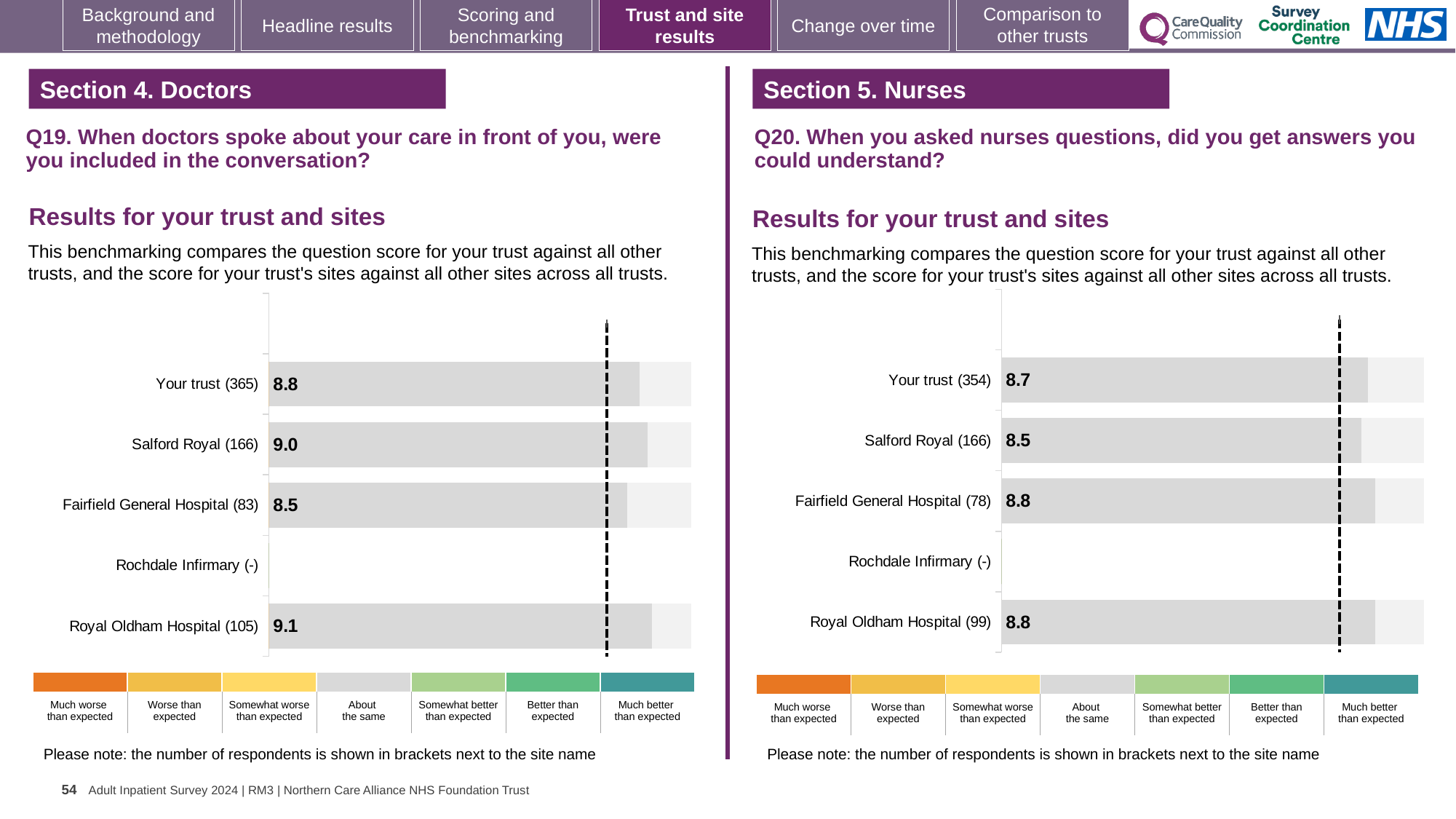
In the Q20 chart on the right, what is the score for Royal Oldham Hospital? 8.8 What kind of chart is used for the Q20 results on the right? Bar chart How many categories are listed on the y axis of the Q19 chart on the left? 5 In the Q19 chart on the left, what is the score for Salford Royal? 9.0 In the Q20 chart on the right, which site has the lowest score? Salford Royal In the Q19 chart on the left, which site has the lowest score? Fairfield General Hospital In the Q19 chart on the left, which site has the highest score? Royal Oldham Hospital In the Q19 chart on the left, what is the score for Your trust? 8.8 In the Q20 chart on the right, which is larger, the score for Fairfield General Hospital or the score for Salford Royal? Fairfield General Hospital In the Q19 chart on the left, what is the difference between the scores for Royal Oldham Hospital and Fairfield General Hospital? 0.6 In the Q20 chart on the right, what is the score for Your trust? 8.7 In the Q20 chart on the right, what is the difference between the scores for Your trust and Salford Royal? 0.2